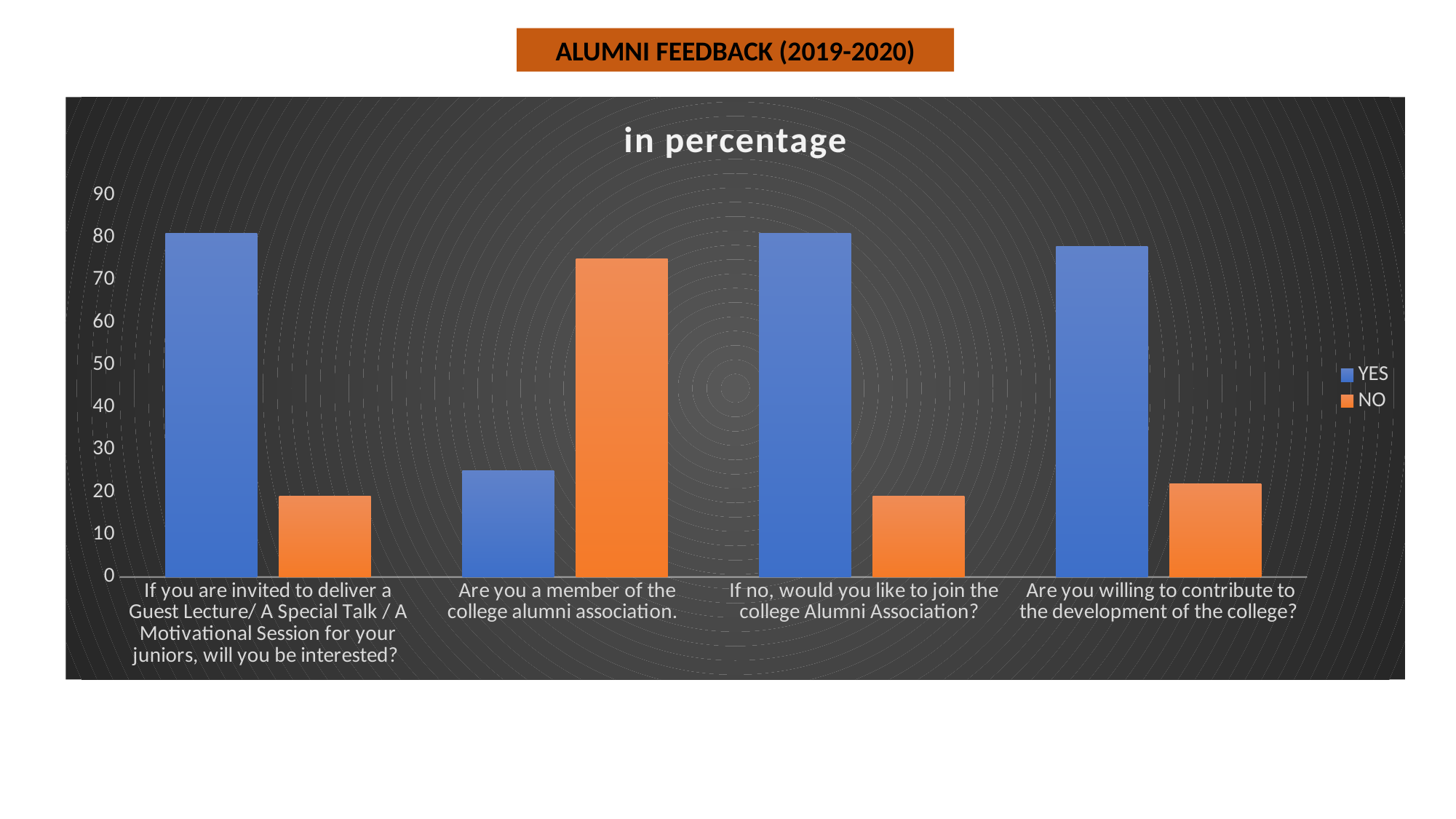
Which question has the lowest YES value? Are you a member of the college alumni association. Is the YES value for "Are you a member of the college alumni association." greater or less than 40? less Is the NO value for "If no, would you like to join the college Alumni Association?" greater or less than 30? less For "Are you willing to contribute to the development of the college?", which is larger, YES or NO? YES What are the two legend entries? YES and NO Is the YES value for "Are you willing to contribute to the development of the college?" greater or less than 70? greater What is the title of the chart? in percentage What kind of chart is shown on the slide? bar chart How many question categories are shown on the x axis? 4 How many series does the legend list? 2 For "Are you a member of the college alumni association.", which is larger, YES or NO? NO